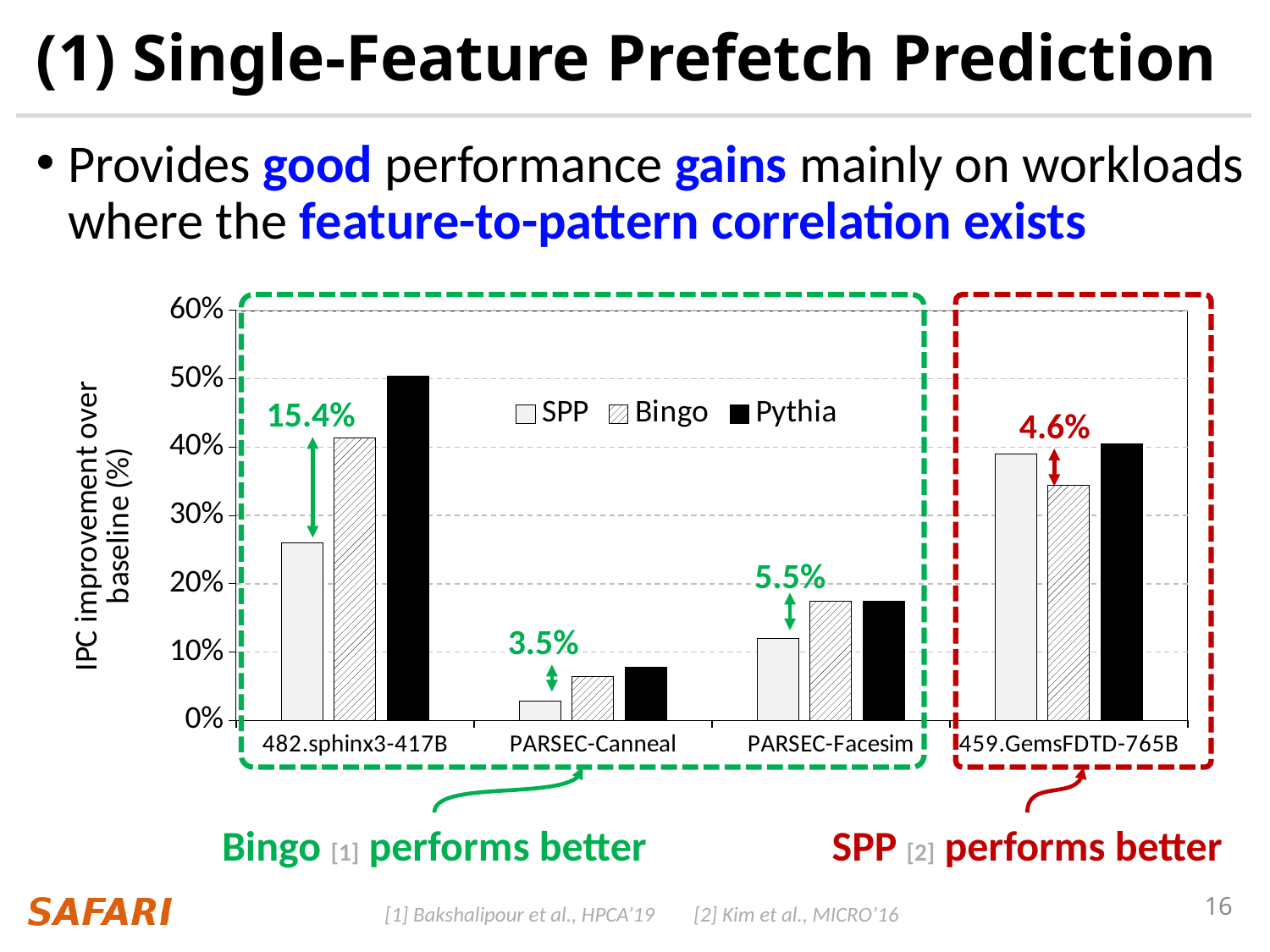
How many workload categories are shown on the x axis of the chart? 4 How many series does the chart's legend list? 3 For which workload is the SPP bar the lowest? PARSEC-Canneal What difference between Bingo and SPP is annotated for PARSEC-Canneal? 3.5% Is the Pythia value for PARSEC-Canneal greater or less than 10%? less What is the label on the chart's y axis? IPC improvement over baseline (%) What are the three series listed in the chart's legend? SPP, Bingo, Pythia What kind of chart is shown on the slide? bar chart What difference between Bingo and SPP is annotated for 482.sphinx3-417B? 15.4% What difference between SPP and Bingo is annotated for 459.GemsFDTD-765B? 4.6% For 459.GemsFDTD-765B, which is larger, the SPP bar or the Bingo bar? SPP For which workload is the Pythia bar the highest? 482.sphinx3-417B